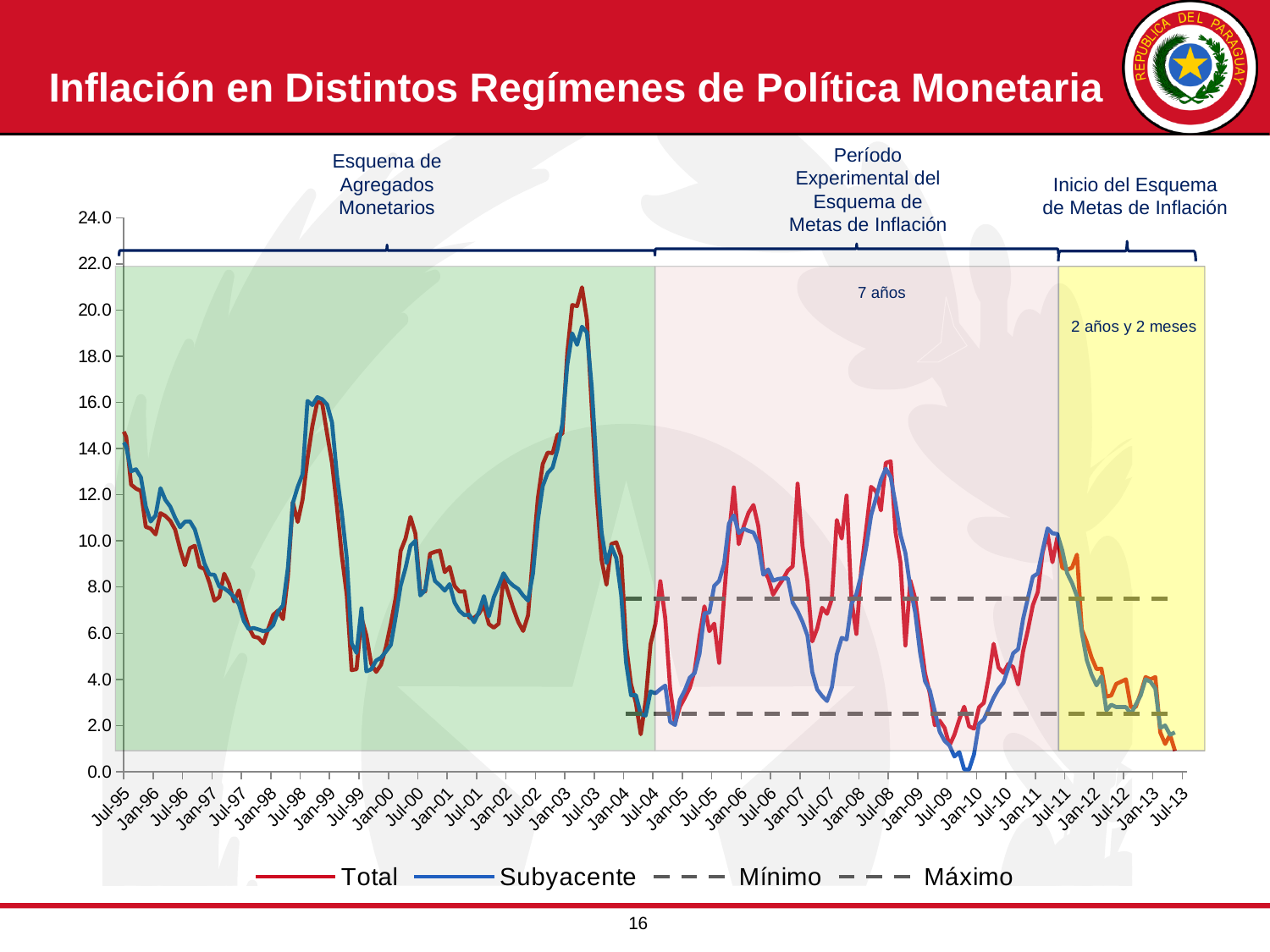
In the 'Inicio del Esquema de Metas de Inflación' period (Jul-11 to Jul-13), do the Total values rise or fall? fall Which series are listed in the legend? Total, Subyacente, Mínimo, Máximo Is the Mínimo dashed line greater or less than 2.0? greater What is the title of the slide? Inflación en Distintos Regímenes de Política Monetaria Is the peak value of the Subyacente series around Jan-03 greater or less than 20.0? less What kind of chart is shown on the slide? line chart Which series reaches the highest peak on the chart? Total Is the Máximo dashed line greater or less than 8.0? less Around Jan-10, which series has the larger value, Total or Subyacente? Total How many series does the legend list? 4